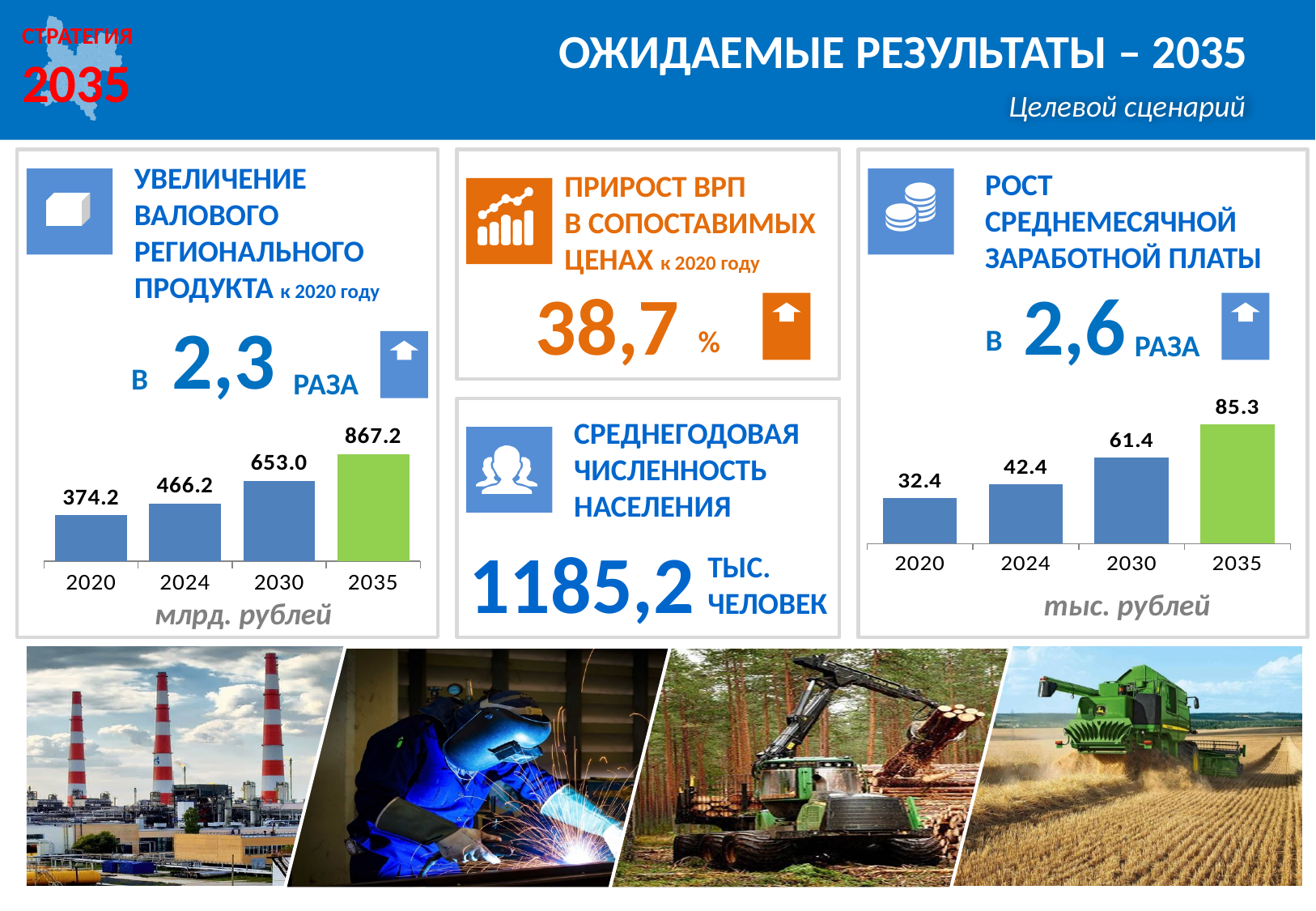
On the left chart (gross regional product), what is the difference between the 2035 and 2020 values? 493.0 How many bars does the left chart (gross regional product) have? 4 On the right chart (average monthly wage), which is larger: the value for 2030 or the value for 2024? 2030 What type of chart is used on the right for average monthly wage? Bar chart On the right chart (average monthly wage), which year has the lowest value? 2020 On the right chart (average monthly wage), what is the difference between the 2030 and 2024 values? 19.0 On the right chart (average monthly wage, тыс. рублей), what is the value for 2035? 85.3 On the left chart (gross regional product), do the values rise or fall from 2020 to 2035? Rise On the left chart (gross regional product, млрд. рублей), what is the value for 2020? 374.2 On the right chart (average monthly wage, тыс. рублей), what is the value for 2024? 42.4 On the left chart (gross regional product, млрд. рублей), what is the value for 2030? 653.0 On the left chart (gross regional product), which year has the highest value? 2035